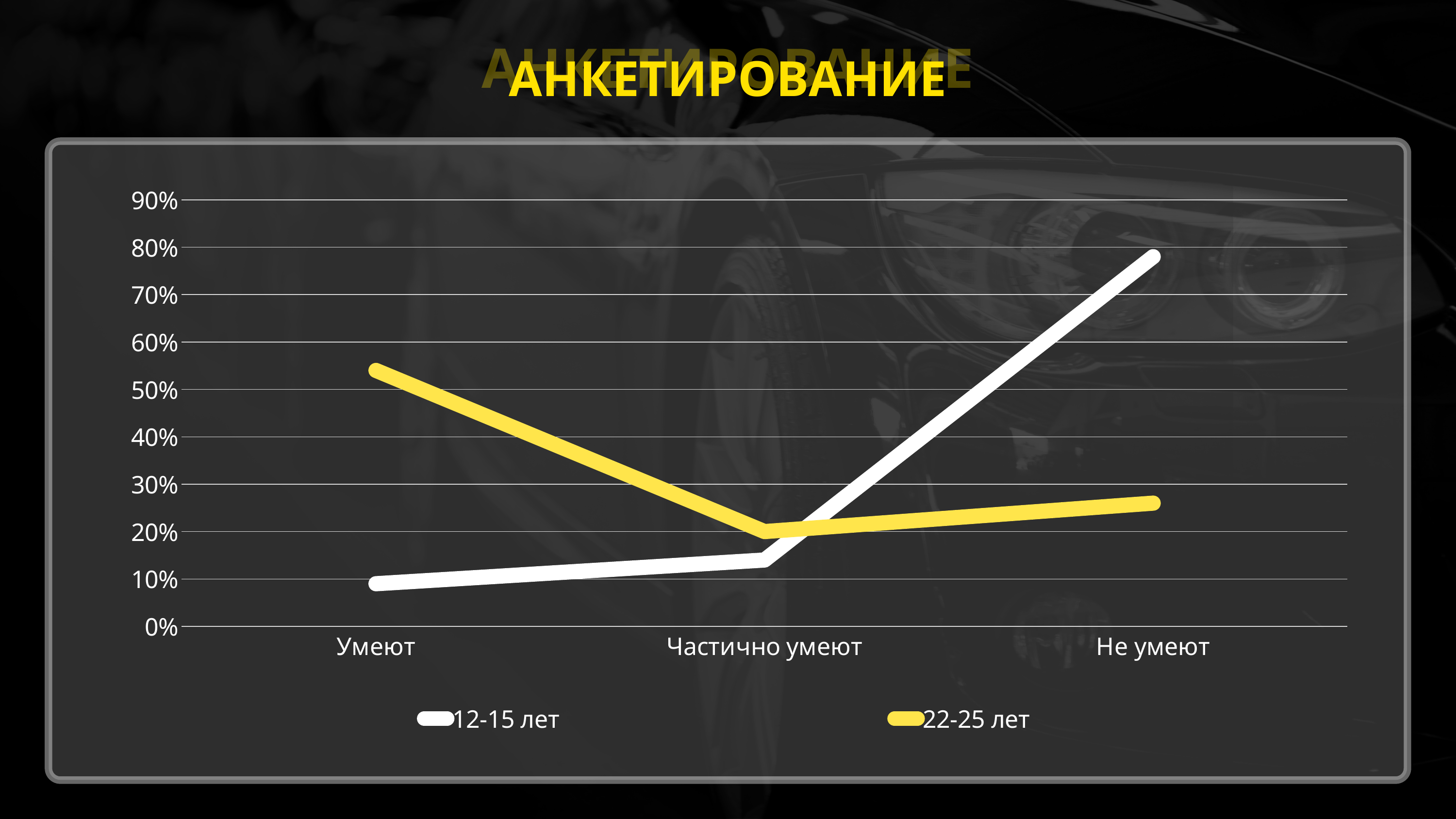
For which category is the 22-25 лет series highest? Умеют At Умеют, which series has the larger value, 12-15 лет or 22-25 лет? 22-25 лет What is the title of the slide above the chart? АНКЕТИРОВАНИЕ How many series does the legend list? 2 Is the value for 12-15 лет at Не умеют greater or less than 70%? greater For which category is the 22-25 лет series lowest? Частично умеют What kind of chart is shown on the slide? line chart Is the value for 22-25 лет at Не умеют greater or less than 30%? less For which category is the 12-15 лет series highest? Не умеют Which colour is used for the 22-25 лет series? yellow How many categories are shown on the x axis? 3 Does the 12-15 лет series rise or fall from Умеют to Не умеют? rise